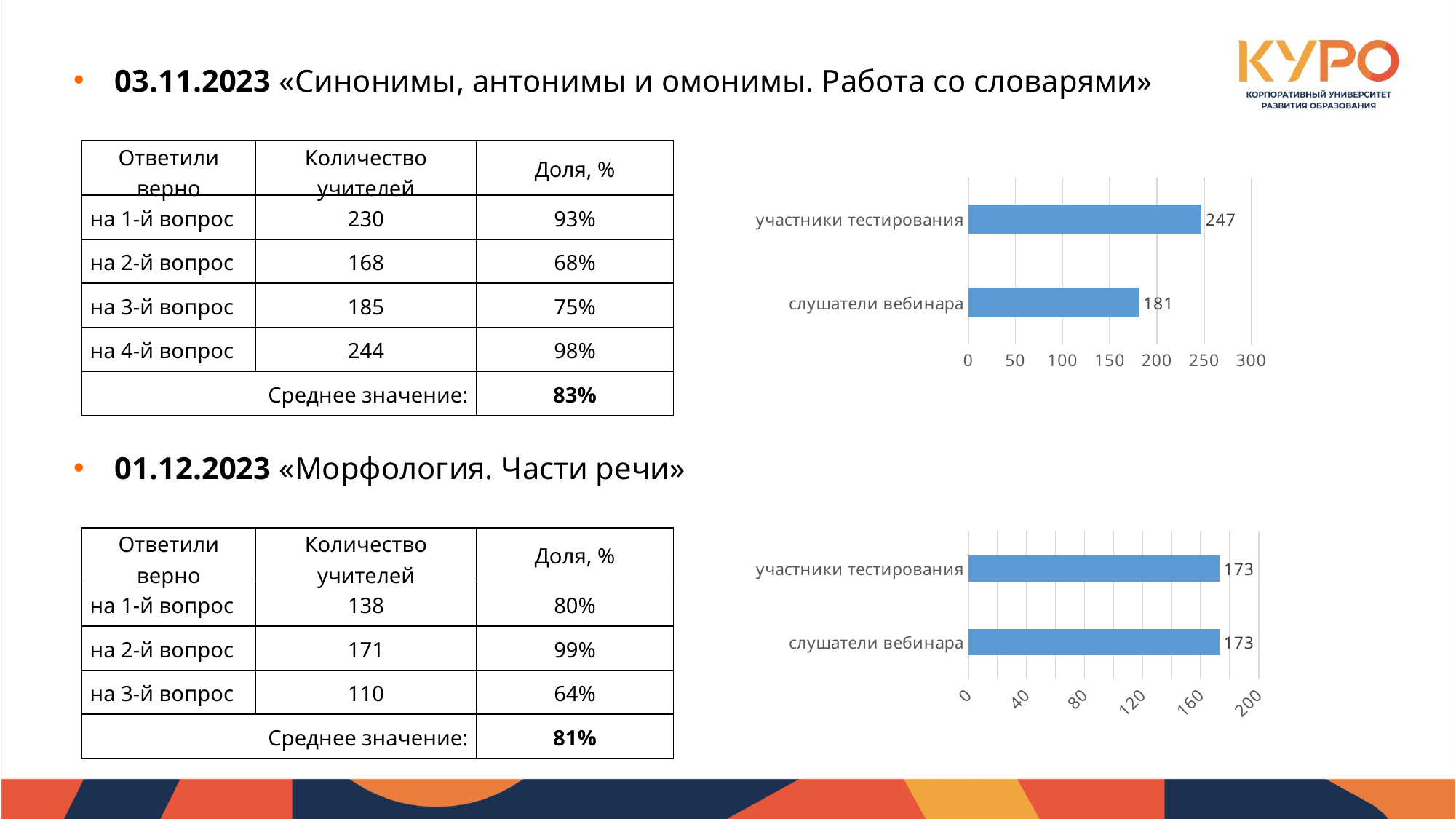
What is the highest tick value on the x axis of the bottom chart? 200 How many categories does the bottom chart show? 2 In the top chart, which category has the highest value? участники тестирования In the top chart, what is the value for слушатели вебинара? 181 In the top chart, is the value for слушатели вебинара greater or less than 200? less In the bottom chart, is the value for участники тестирования greater or less than 160? greater What kind of chart is the top chart? bar chart In the bottom chart, what is the value for слушатели вебинара? 173 In the bottom chart, what is the value for участники тестирования? 173 In the top chart, which category has the lowest value? слушатели вебинара In the top chart, what is the difference between участники тестирования and слушатели вебинара? 66 In the top chart, what is the value for участники тестирования? 247